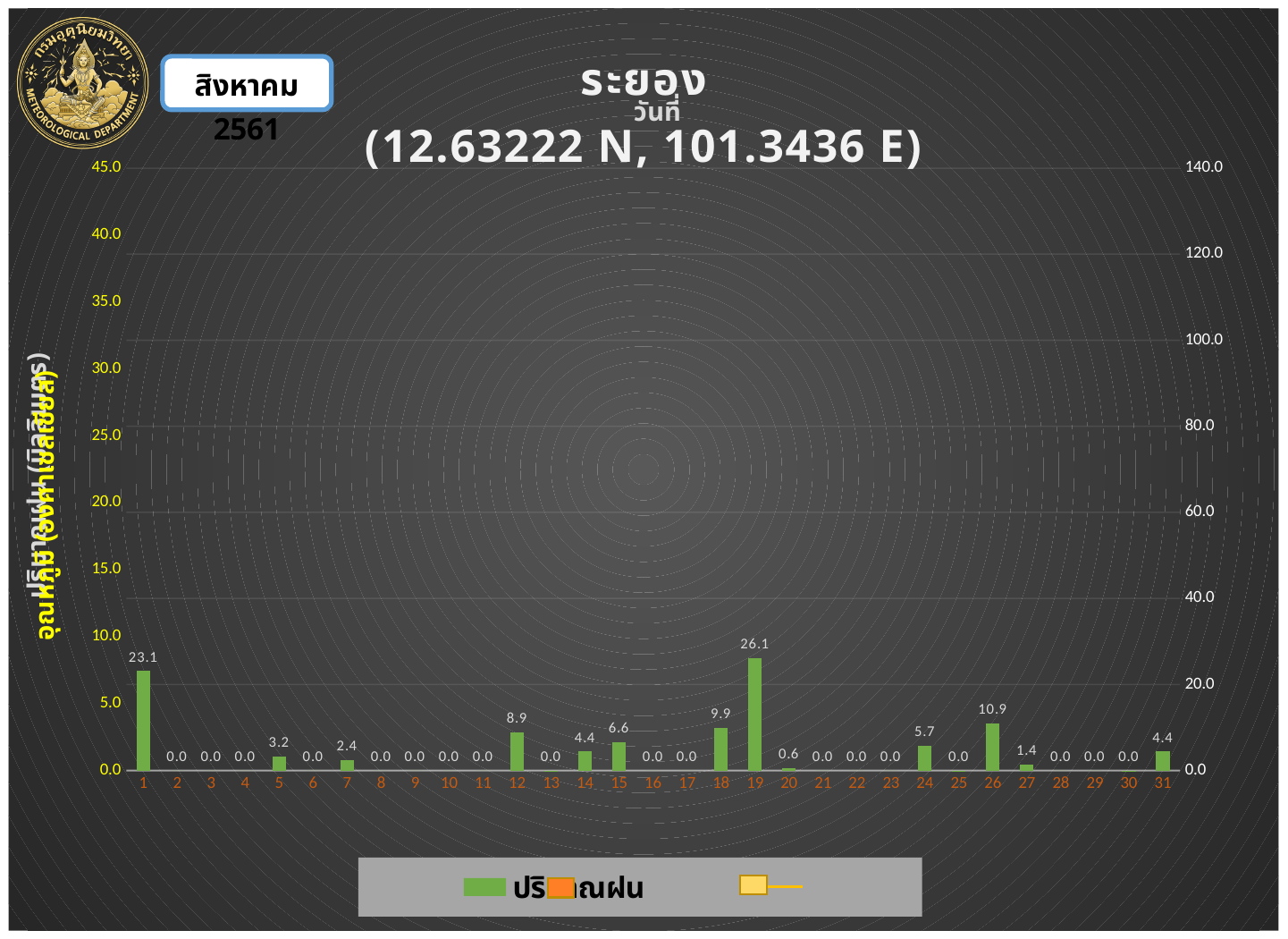
What is the rainfall value shown for day 20? 0.6 What is the rainfall value shown for day 12? 8.9 Which is larger, the rainfall value for day 15 or for day 14? day 15 What is the difference between the rainfall values for day 19 and day 1? 3.0 What is the rainfall value shown for day 19? 26.1 What kind of chart is shown on the slide? bar chart Which is larger, the rainfall value for day 24 or for day 5? day 24 Which day has the highest rainfall value? 19 What is the rainfall value shown for day 1? 23.1 How many days are shown on the x axis? 31 What is the rainfall value shown for day 26? 10.9 What is the difference between the rainfall values for day 26 and day 18? 1.0